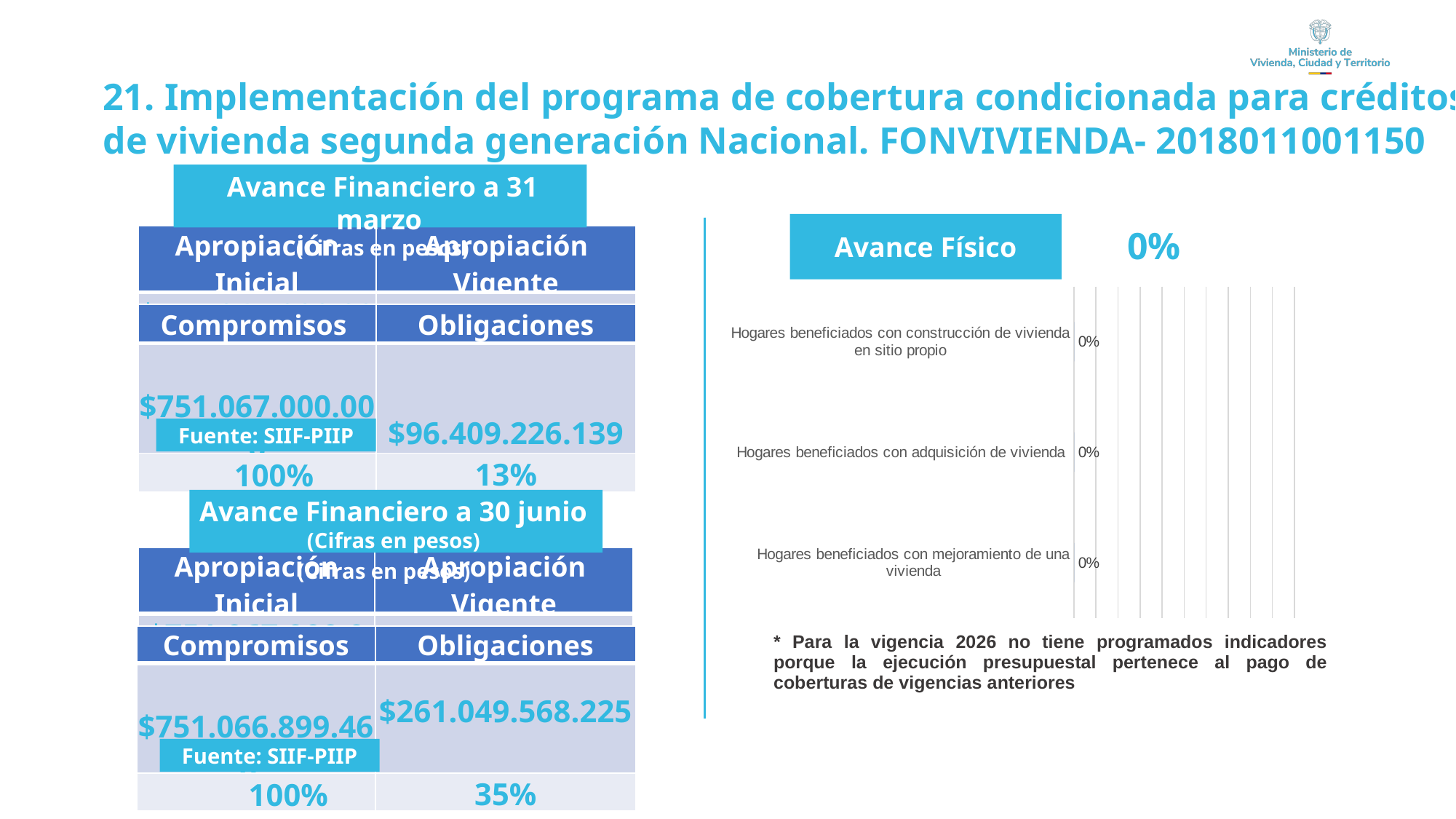
How many categories does the "Avance Físico" chart show? 3 What kind of chart is shown under the "Avance Físico" heading? bar chart In the "Avance Físico" chart, what is the value for "Hogares beneficiados con mejoramiento de una vivienda"? 0% In the "Avance Físico" chart, what is the value for "Hogares beneficiados con adquisición de vivienda"? 0% What overall percentage is displayed next to the "Avance Físico" heading? 0% In the "Avance Físico" chart, what is the difference between the values for "Hogares beneficiados con adquisición de vivienda" and "Hogares beneficiados con mejoramiento de una vivienda"? 0% What is the title of the chart on the right side of the slide? Avance Físico In the "Avance Físico" chart, what is the value for "Hogares beneficiados con construcción de vivienda en sitio propio"? 0%